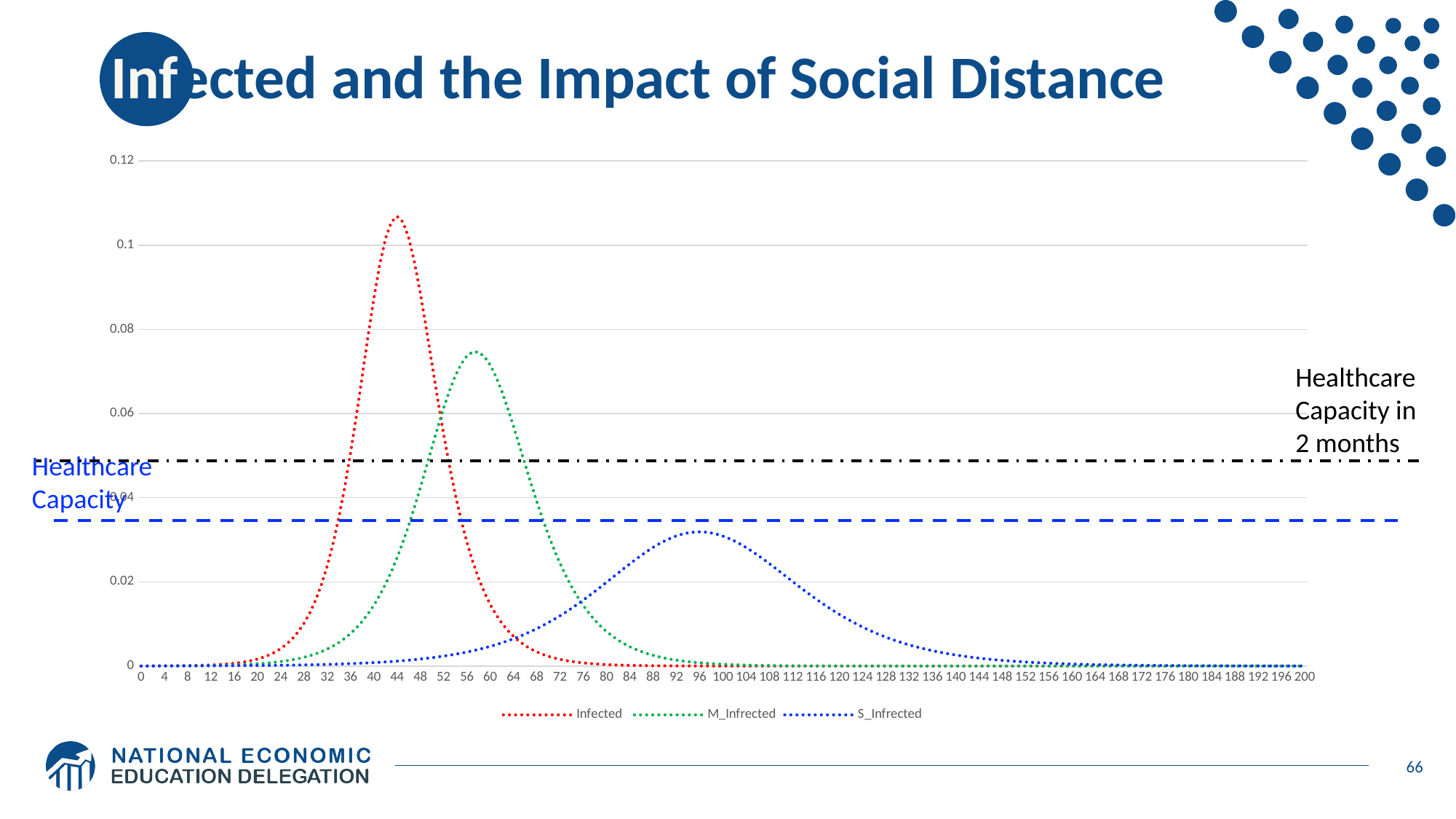
Is the peak value of the S_Infrected series greater or less than 0.04? less What colour is the S_Infrected series drawn in? blue What kind of chart is shown on the slide? line chart Is the peak value of the M_Infrected series greater or less than 0.08? less Which series reaches the highest peak value? Infected How many series does the chart legend list? 3 Which series has the lowest peak value? S_Infrected Which series peaks furthest to the right along the x axis? S_Infrected At x = 44, which series has the larger value, Infected or M_Infrected? Infected At x = 96, which series has the larger value, S_Infrected or Infected? S_Infrected Which horizontal reference line is higher on the chart, Healthcare Capacity or Healthcare Capacity in 2 months? Healthcare Capacity in 2 months Is the peak value of the Infected series greater or less than 0.1? greater